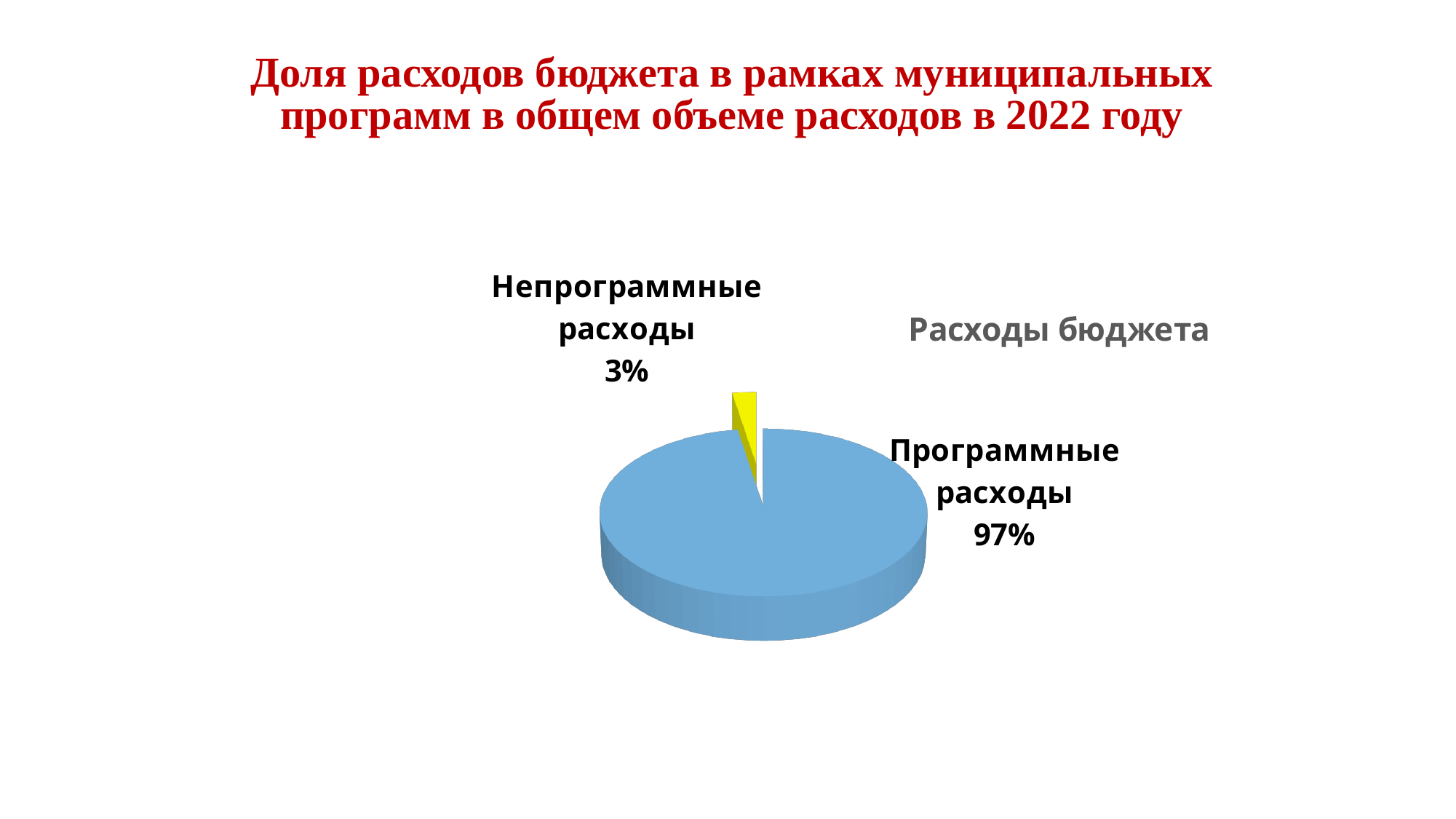
Which slice of the pie is the smallest? Непрограммные расходы What is the title of the chart shown inside the chart area? Расходы бюджета Which is larger: the "Программные расходы" slice or the "Непрограммные расходы" slice? Программные расходы What share of the pie is labelled "Программные расходы"? 97% What colour is the "Непрограммные расходы" slice? Yellow How many slices does the pie chart have? 2 What is the difference in percentage points between the "Программные расходы" and "Непрограммные расходы" slices? 94 What kind of chart is shown on the slide? Pie chart Which slice of the pie is the largest? Программные расходы What share of the pie is labelled "Непрограммные расходы"? 3%